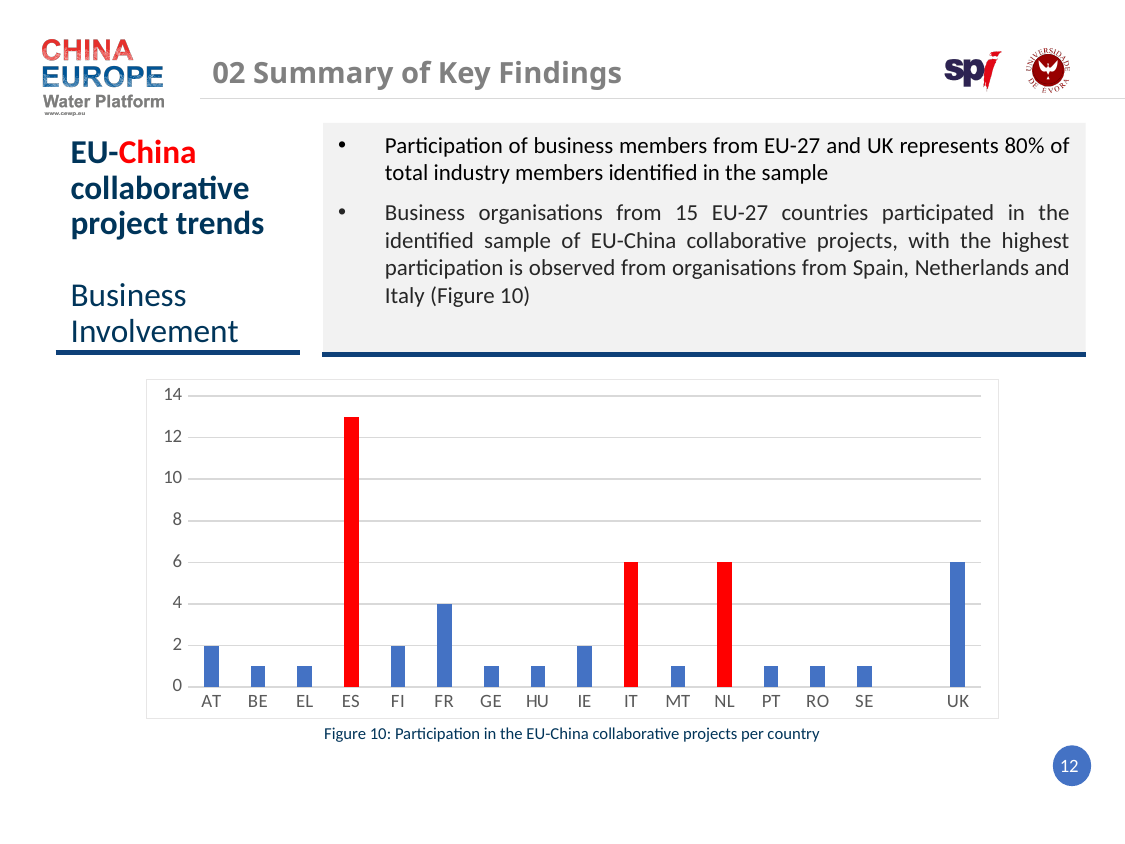
What is the value for AT? 2 Is the value for BE greater or less than 2? less What is the caption of the figure below the chart? Figure 10: Participation in the EU-China collaborative projects per country Which country has the highest bar in the chart? ES What is the difference between the values for FR and AT? 2 What is the value for FR? 4 How many countries are shown on the x axis of the chart? 16 Which is larger, the value for FR or the value for AT? FR What is the value for UK? 6 Is the value for ES greater or less than 12? greater Which countries' bars are coloured red in the chart? ES, IT and NL What type of chart is shown on the slide? bar chart